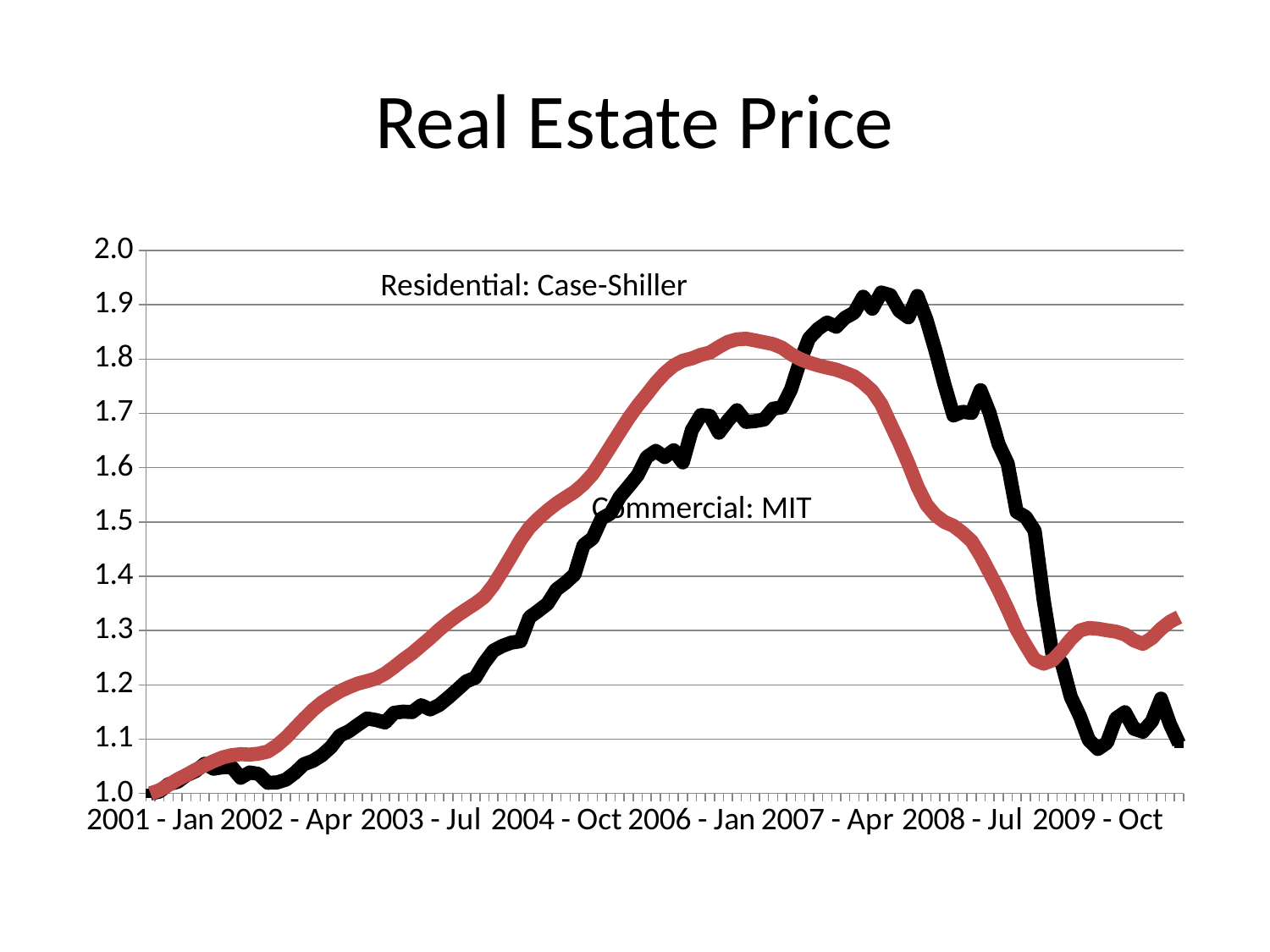
Is the value for Residential: Case-Shiller at 2008 - Jul greater or less than 1.6? less Which series reaches the higher peak value over the period shown? Commercial: MIT Is the value for Residential: Case-Shiller at 2006 - Jan greater or less than 1.7? greater Does the Residential: Case-Shiller series rise or fall between 2001 - Jan and 2006 - Jan? Rise How many data series are plotted on the chart? 2 At 2009 - Oct, which series has the higher value, Residential: Case-Shiller or Commercial: MIT? Residential: Case-Shiller Is the value for Commercial: MIT at 2007 - Apr greater or less than 1.8? greater What kind of chart is shown on the slide? Line chart What is the title of the chart? Real Estate Price How many labels are shown on the x axis? 8 Which series is drawn in red? Residential: Case-Shiller